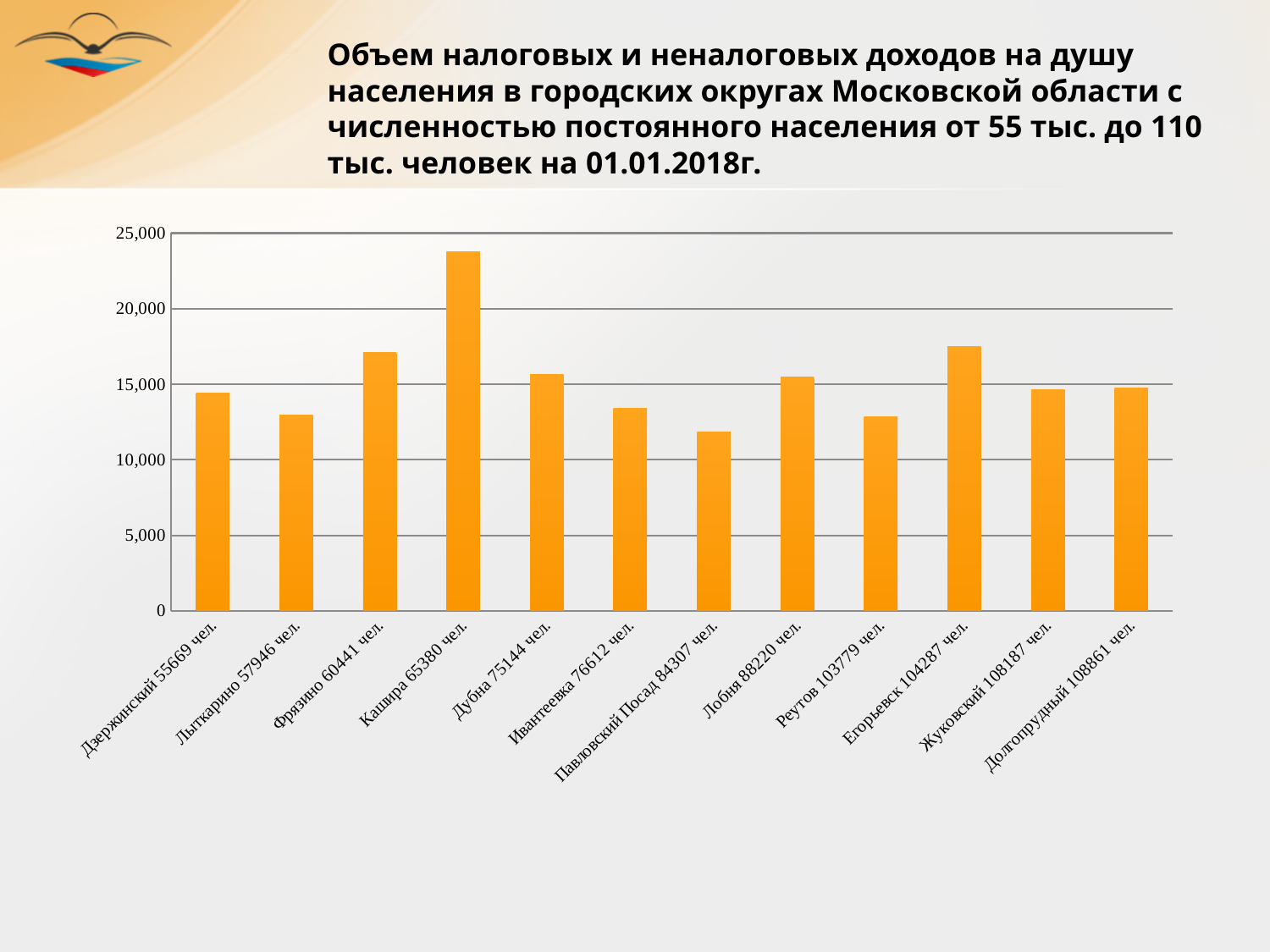
Which is larger, the value for Лобня or the value for Павловский Посад? Лобня Is the value for Кашира greater or less than 20,000? greater Which is larger, the value for Дубна or the value for Лыткарино? Дубна Is the value for Реутов greater or less than 15,000? less What colour are the bars in the chart? Orange What kind of chart is shown on the slide? Bar chart Which city district has the lowest per-capita revenue in the chart? Павловский Посад 84307 чел. Is the value for Фрязино greater or less than 15,000? greater Which city district has the highest per-capita revenue in the chart? Кашира 65380 чел. How many city districts (bars) are shown in the chart? 12